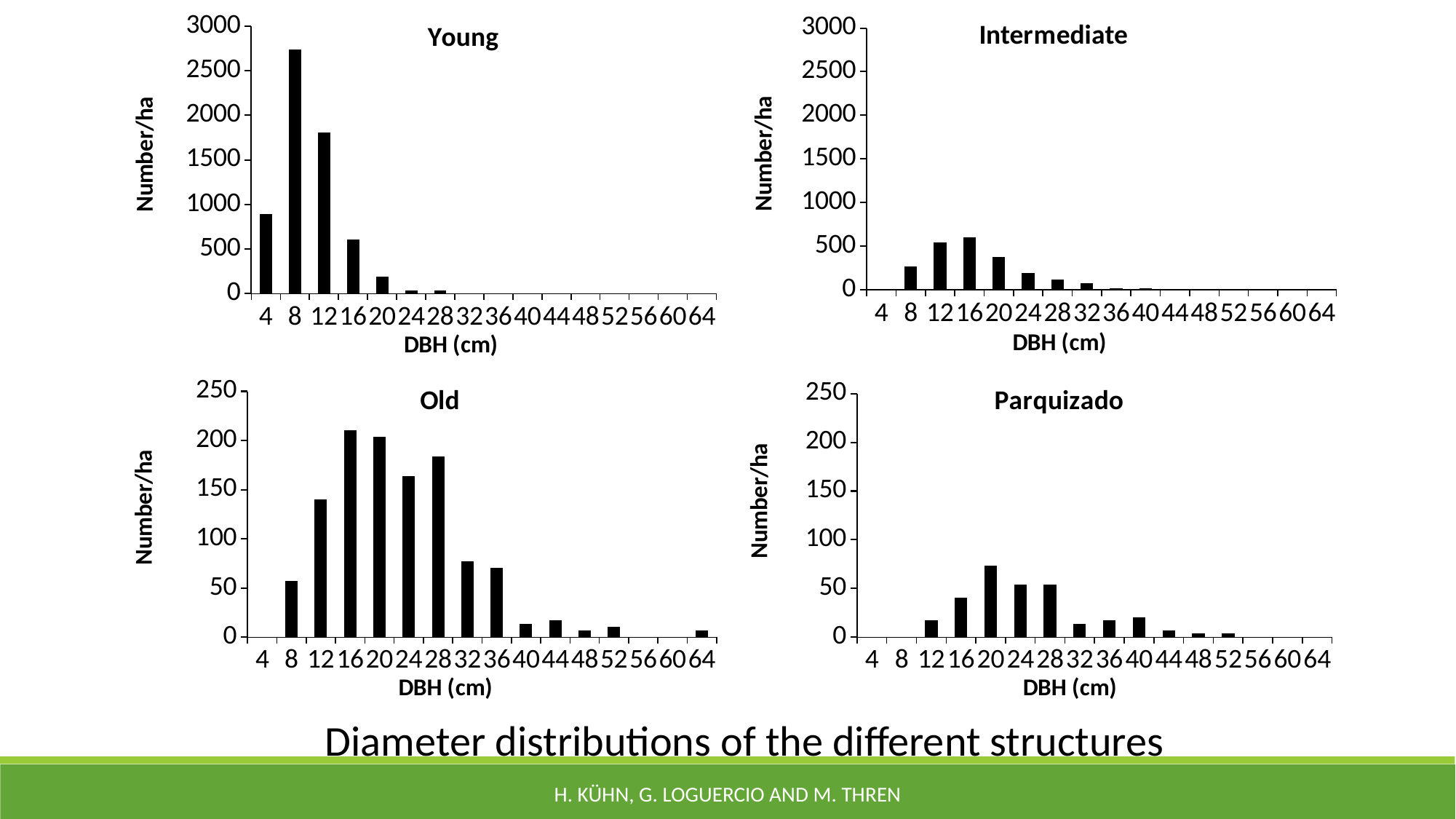
What kind of chart is the Old chart? bar chart In the Old chart, is the value for DBH 16 cm greater or less than 200? greater What is the y-axis label on the Intermediate chart? Number/ha In the Parquizado chart, is the value for DBH 16 cm greater or less than 50? less In the Young chart, which is larger, the value for DBH 8 cm or DBH 12 cm? DBH 8 cm In the Old chart, which is larger, the value for DBH 12 cm or DBH 32 cm? DBH 12 cm In the Intermediate chart, is the value for DBH 16 cm greater or less than 500? greater In the Parquizado chart, which DBH class has the highest Number/ha? 20 In the Intermediate chart, which DBH class has the highest Number/ha? 16 In the Young chart, which DBH class has the highest Number/ha? 8